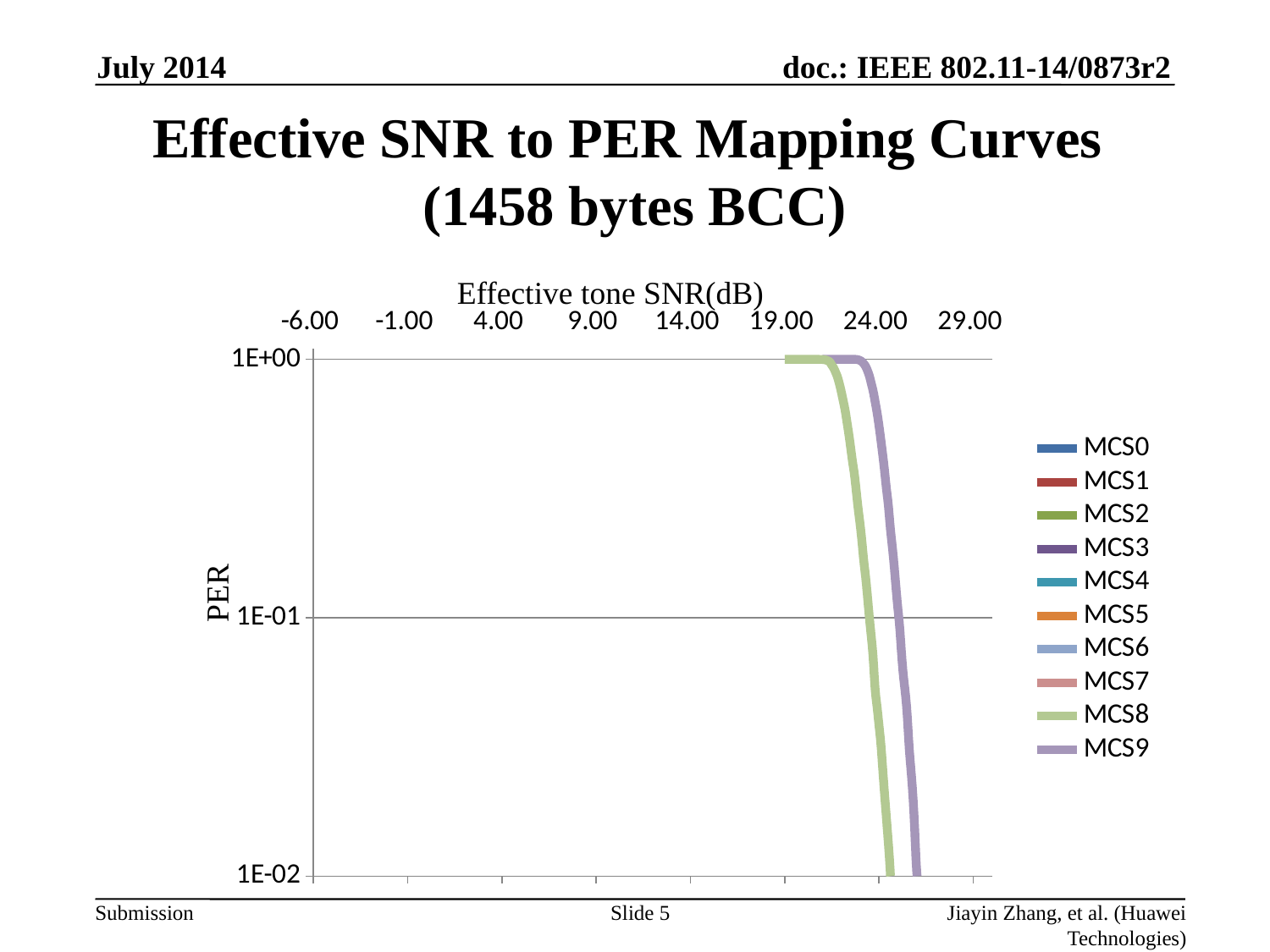
What is the lowest value labelled on the PER axis? 1E-02 What is the label of the vertical axis? PER As the effective tone SNR increases, does the PER of the MCS8 curve rise or fall? fall What is the highest value labelled on the effective tone SNR axis? 29.00 Which curve reaches a PER of 1E-02 at the higher effective tone SNR, MCS8 or MCS9? MCS9 Which of the two visible curves, MCS8 or MCS9, lies further to the right (requires higher SNR for the same PER)? MCS9 Is the PER of the MCS9 curve at 19.00 dB greater or less than 1E-01? greater What kind of chart is shown on the slide? line chart How many series does the legend list? 10 At an effective tone SNR of 24.00 dB, which curve has the lower PER, MCS8 or MCS9? MCS8 What is the label of the horizontal axis? Effective tone SNR(dB)